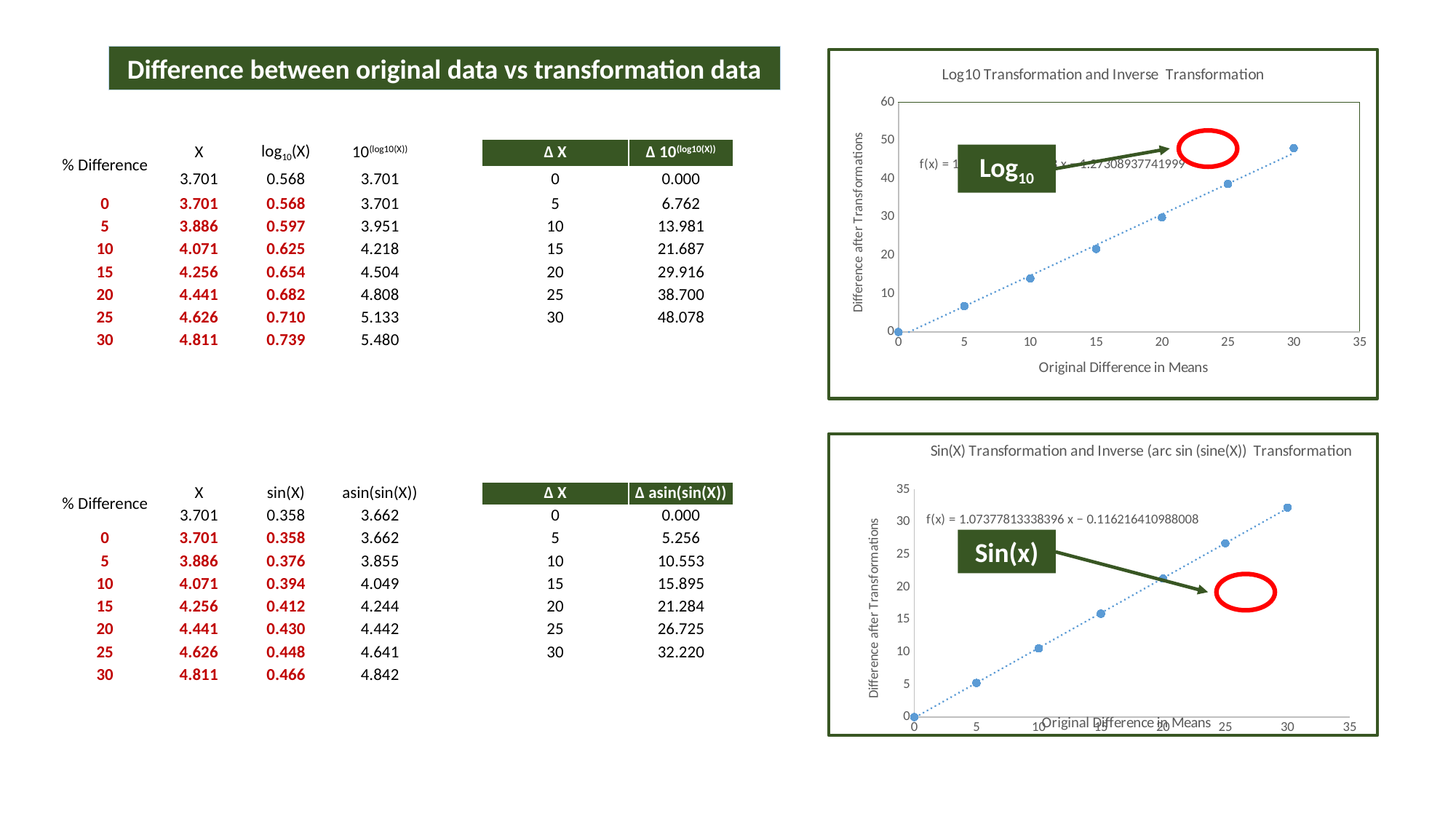
What kind of chart is the 'Log10 Transformation and Inverse Transformation' chart? scatter chart What is the x-axis title of the 'Log10 Transformation and Inverse Transformation' chart? Original Difference in Means In the 'Log10 Transformation and Inverse Transformation' chart, how many data points are plotted? 7 In the 'Log10 Transformation and Inverse Transformation' chart, is the value at an original difference of 5 greater or less than 10? less In the 'Sin(X) Transformation and Inverse (arc sin (sine(X)) Transformation' chart, is the value at an original difference of 5 greater or less than 10? less In the 'Sin(X) Transformation and Inverse (arc sin (sine(X)) Transformation' chart, is the value at an original difference of 30 greater or less than 30? greater In the 'Sin(X) Transformation and Inverse (arc sin (sine(X)) Transformation' chart, how many data points are plotted? 7 In the 'Log10 Transformation and Inverse Transformation' chart, do the values rise or fall as the original difference in means increases? rise What is the y-axis title of the 'Sin(X) Transformation and Inverse (arc sin (sine(X)) Transformation' chart? Difference after Transformations In the 'Log10 Transformation and Inverse Transformation' chart, which is larger: the value at an original difference of 30 or at 25? 30 In the 'Log10 Transformation and Inverse Transformation' chart, what is the value plotted at an original difference of 0? 0